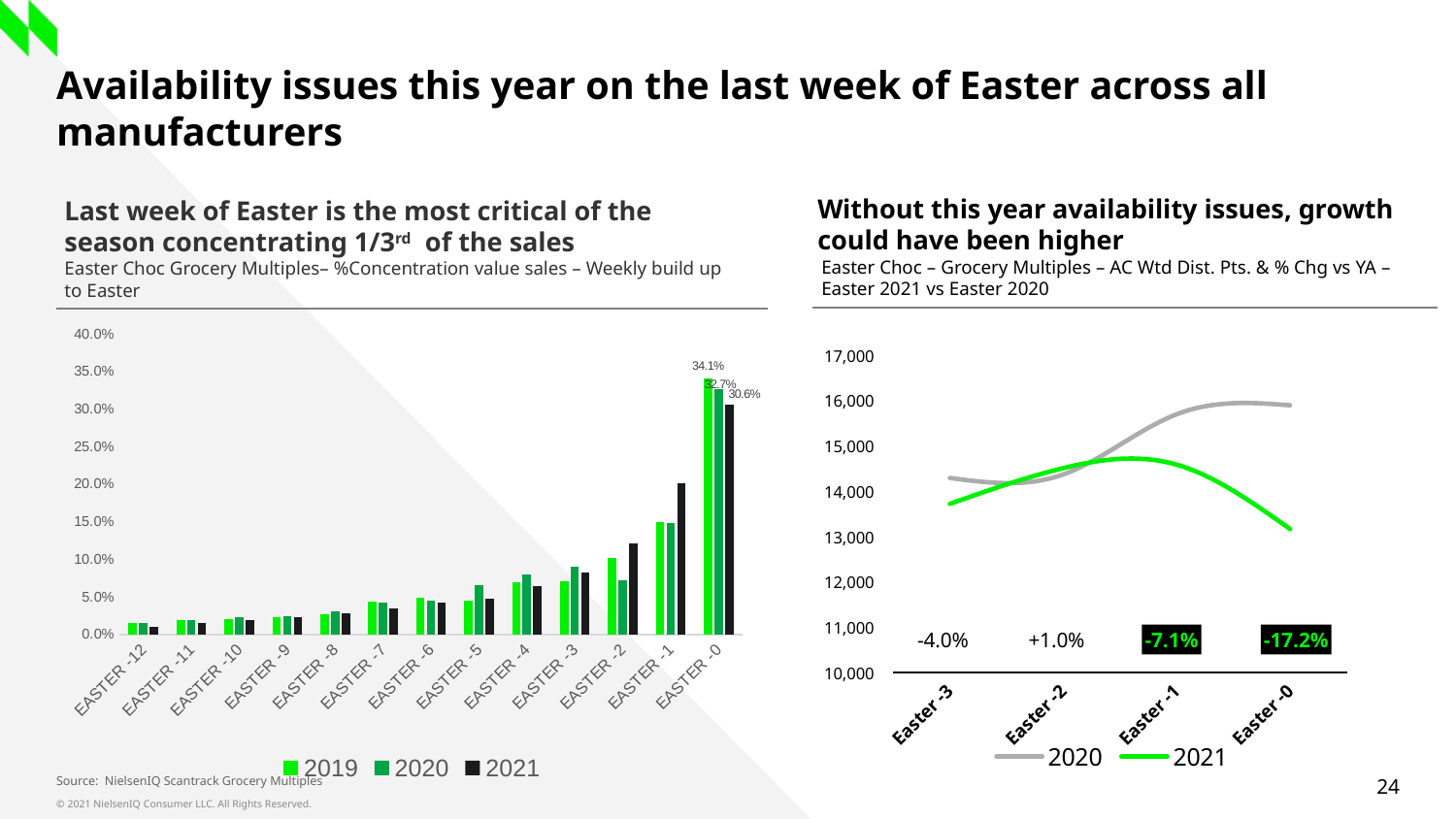
On the right chart, is the 2021 value at Easter -0 greater or less than 14,000? less On the left chart, how many Easter week categories are shown on the x axis? 13 On the left chart, do the values generally rise or fall from EASTER -12 to EASTER -0? rise On the right chart, how many series does the legend list? 2 On the left chart, what is the 2019 value for EASTER -0? 34.1% On the left chart, which series has the highest value at EASTER -0? 2019 On the left chart, what is the difference between the 2019 and 2021 values at EASTER -0? 3.5 percentage points What kind of chart is the chart on the right? line chart On the left chart, what is the 2020 value for EASTER -0? 32.7% On the left chart, what is the 2021 value for EASTER -0? 30.6% On the right chart, what % change vs YA is shown for Easter -0? -17.2% On the left chart, is the 2021 value for EASTER -1 greater or less than 15.0%? greater